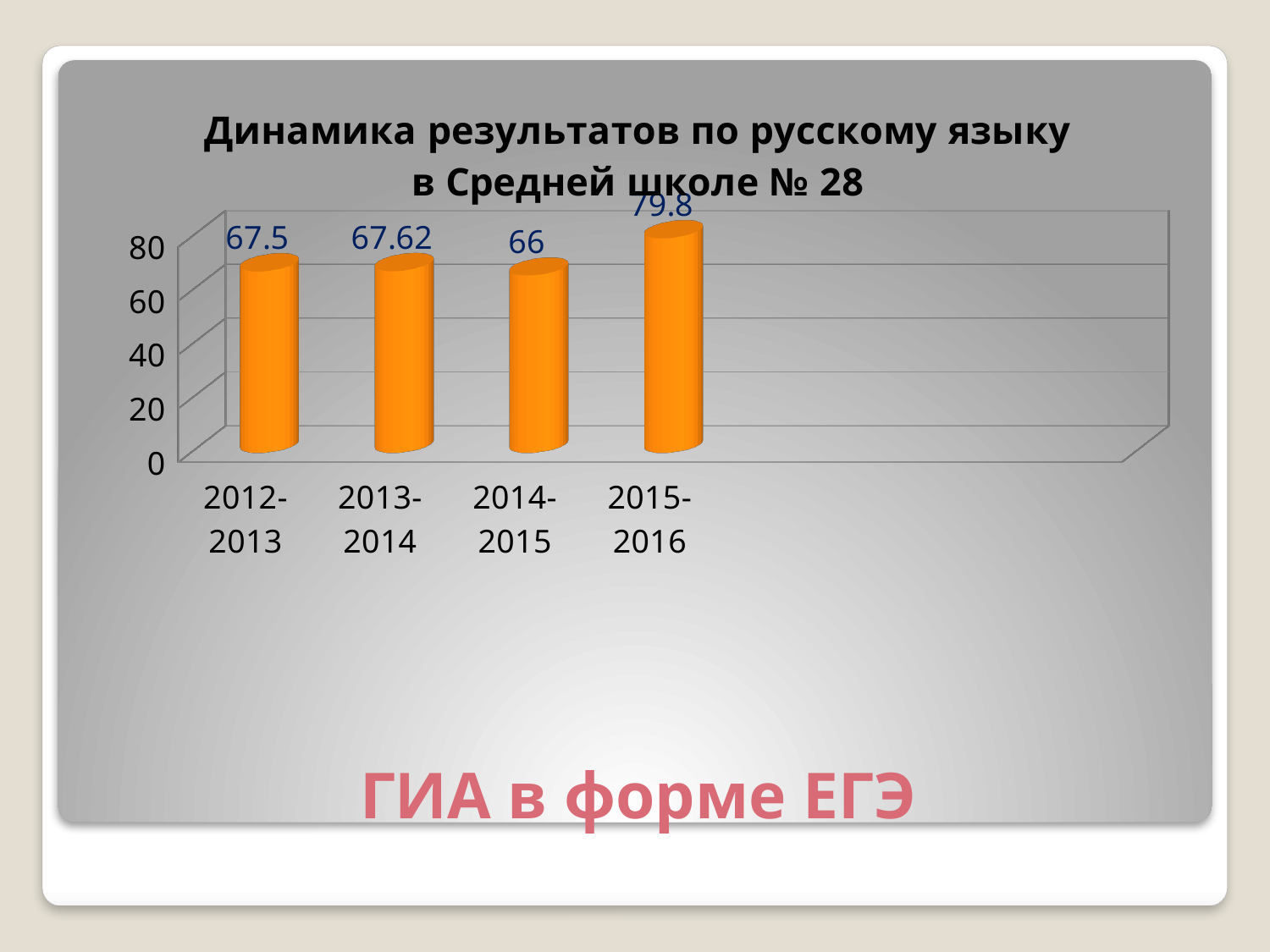
Is the value for 2015-2016 greater or less than 60? greater Which year has the lowest value? 2014-2015 What is the value for 2015-2016? 79.8 What kind of chart is shown on the slide? bar chart What is the difference between the values for 2012-2013 and 2014-2015? 1.5 What is the value for 2012-2013? 67.5 What is the value for 2013-2014? 67.62 Which year has the highest value? 2015-2016 Which is larger, the value for 2015-2016 or the value for 2012-2013? 2015-2016 What is the difference between the values for 2015-2016 and 2014-2015? 13.8 What is the value for 2014-2015? 66 How many years are shown on the chart? 4